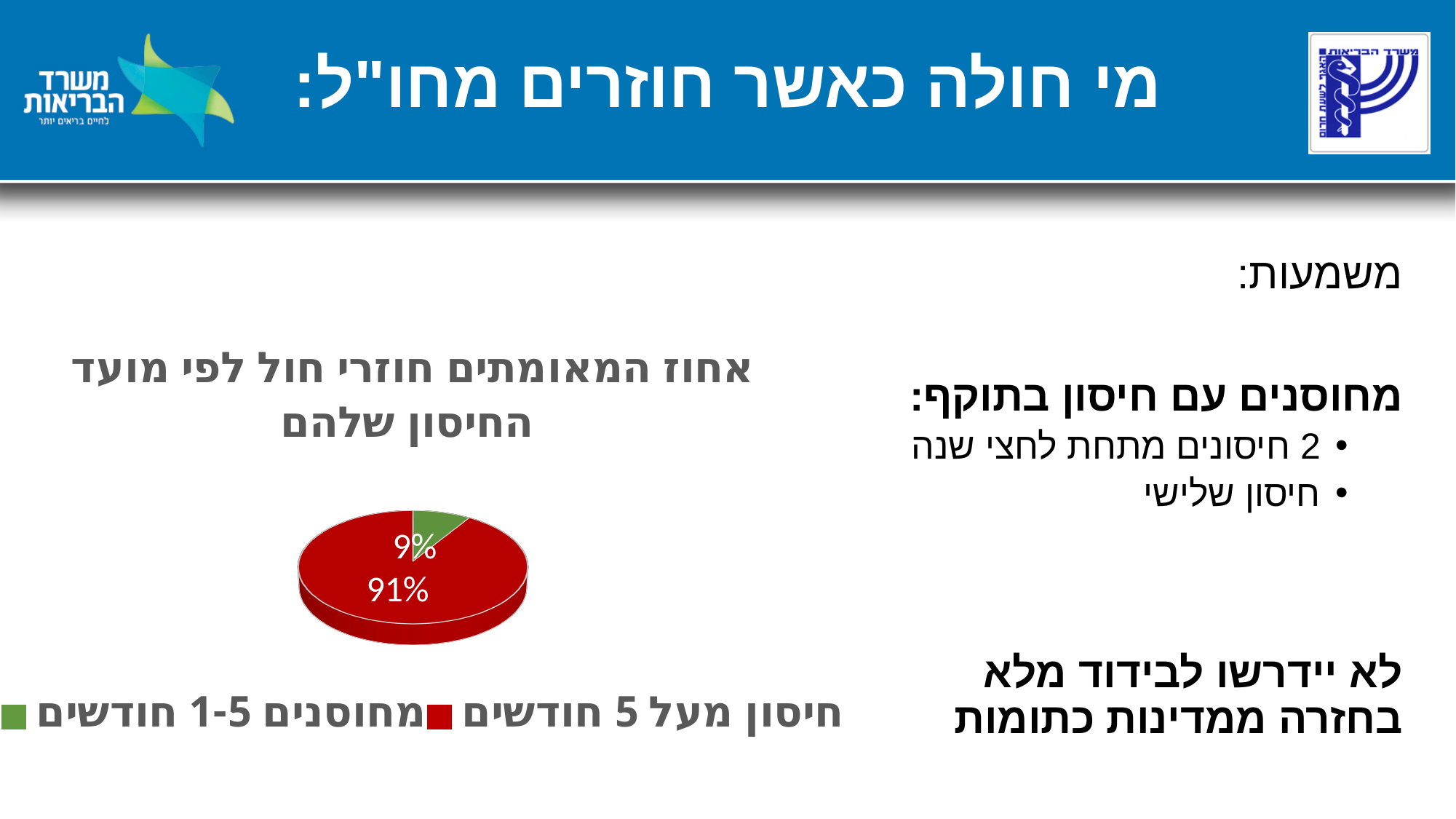
What is the value for the slice labelled "מחוסנים 1-5 חודשים"? 9% What share of the pie does the green slice represent? 9% How many entries does the legend list? 2 What is the title of the pie chart? אחוז המאומתים חוזרי חול לפי מועד החיסון שלהם What is the difference between the shares of "מחוסנים 1-5 חודשים" and "חיסון מעל 5 חודשים"? 82% Which category has the smallest share of the pie? מחוסנים 1-5 חודשים What type of chart is shown on the slide? pie chart What is the value for the slice labelled "חיסון מעל 5 חודשים"? 91% What colour is the slice for "חיסון מעל 5 חודשים"? red Which is larger: the share for "מחוסנים 1-5 חודשים" or the share for "חיסון מעל 5 חודשים"? חיסון מעל 5 חודשים How many slices does the pie chart have? 2 Which category has the largest share of the pie? חיסון מעל 5 חודשים